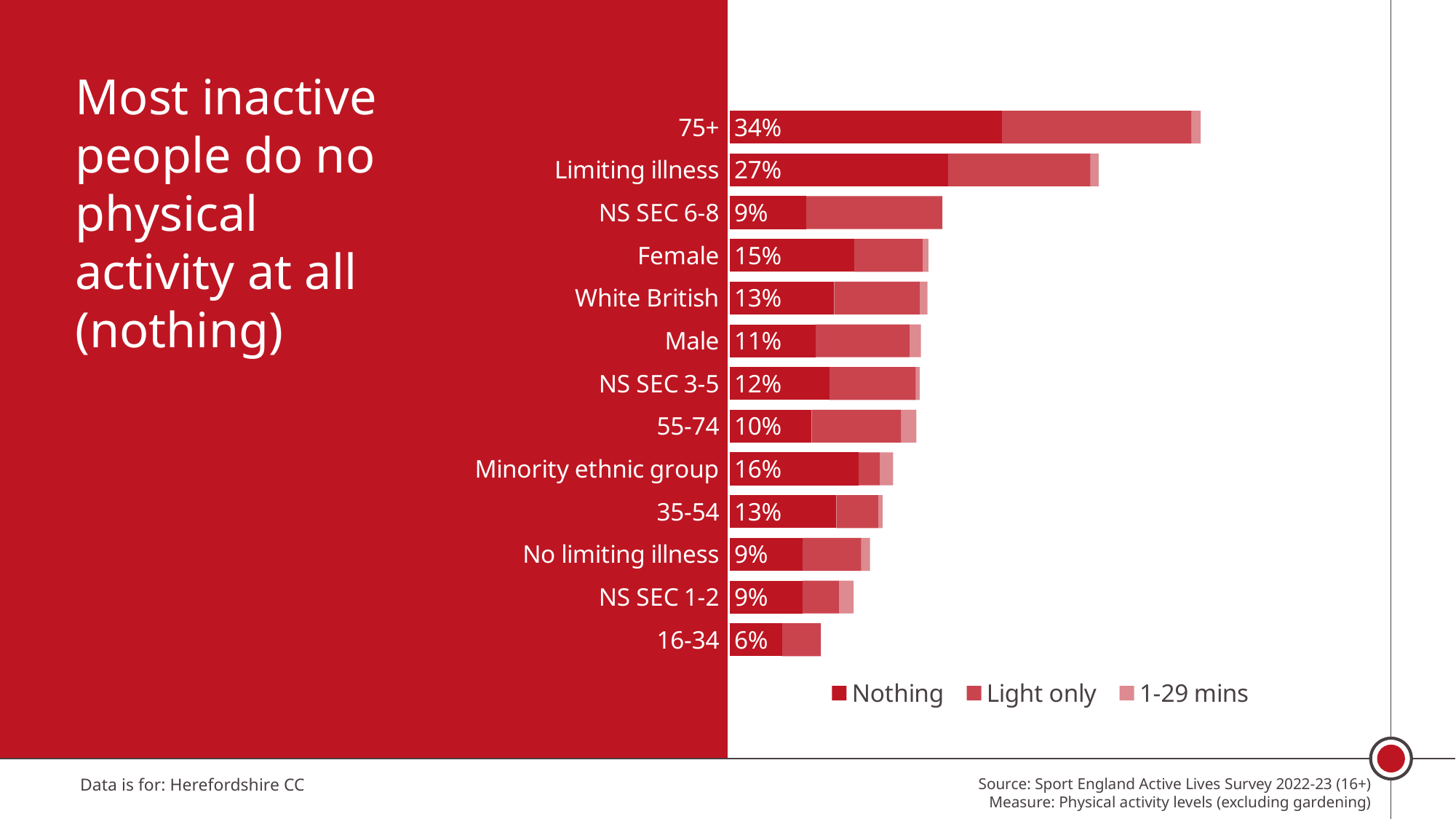
What is the 'Nothing' value for the Minority ethnic group? 16% How many series does the legend list? 3 Which group has the lowest 'Nothing' percentage? 16-34 What is the 'Nothing' value for the Limiting illness group? 27% What type of chart is shown on the slide? Bar chart What are the three series named in the legend? Nothing, Light only, 1-29 mins Which group has the highest 'Nothing' percentage? 75+ How many groups (categories) are shown in the chart? 13 What percentage of people aged 75+ do nothing (no physical activity)? 34% What is the 'Nothing' value for the 16-34 age group? 6% What is the difference in the 'Nothing' percentage between the 75+ group and the Limiting illness group? 7 percentage points Which has a higher 'Nothing' percentage, Female or Male? Female